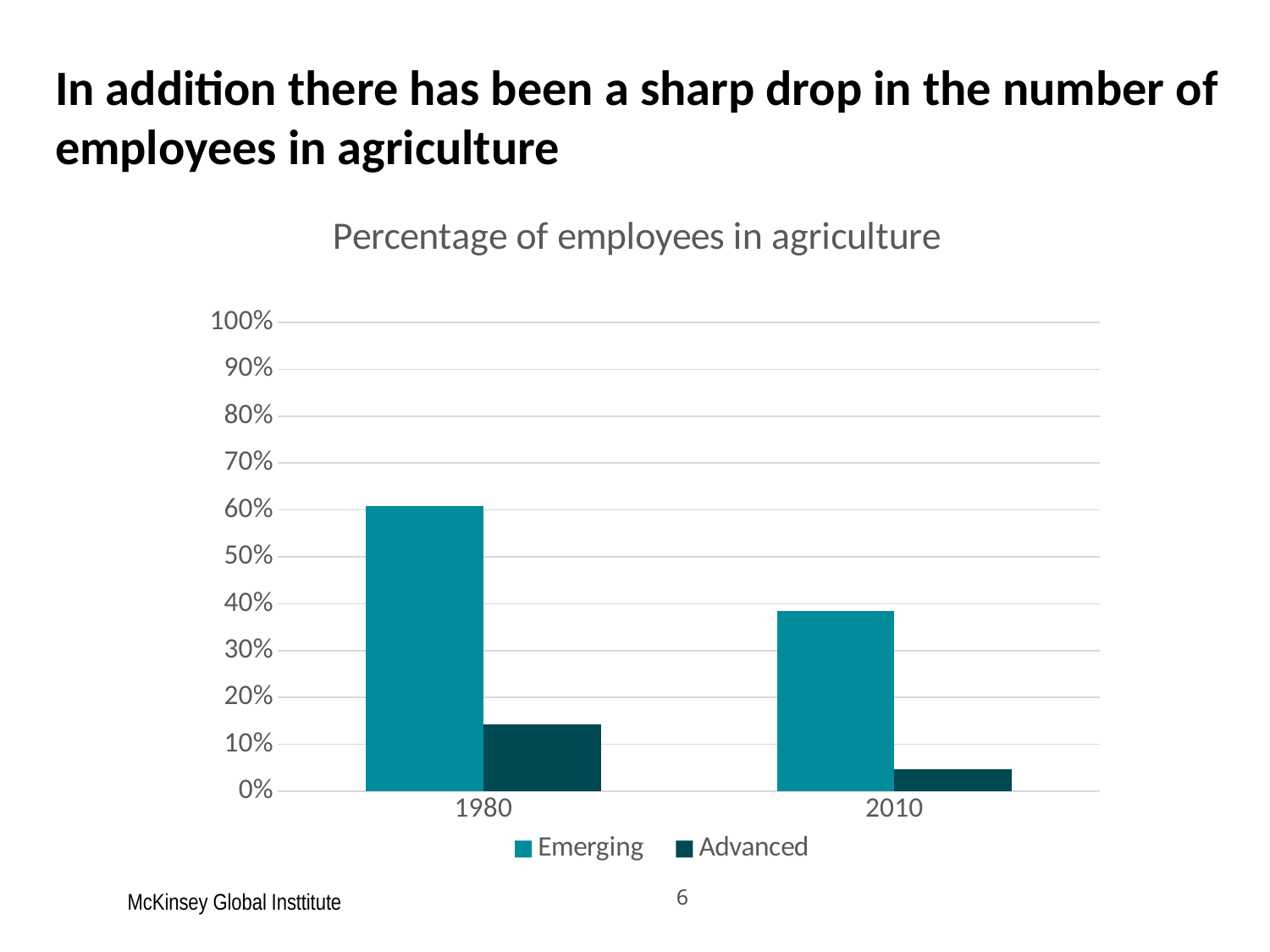
Which bar is the highest in the chart? Emerging in 1980 Is the value for Emerging in 2010 greater or less than 30%? greater How many series does the legend list? 2 Is the value for Emerging in 1980 greater or less than 50%? greater What is the title of the chart? Percentage of employees in agriculture Which bar is the lowest in the chart? Advanced in 2010 How many year categories are shown on the x axis? 2 Does the Emerging series rise or fall from 1980 to 2010? fall Which series are listed in the legend? Emerging, Advanced What kind of chart is shown on the slide? bar chart Is the value for Advanced in 2010 greater or less than 10%? less